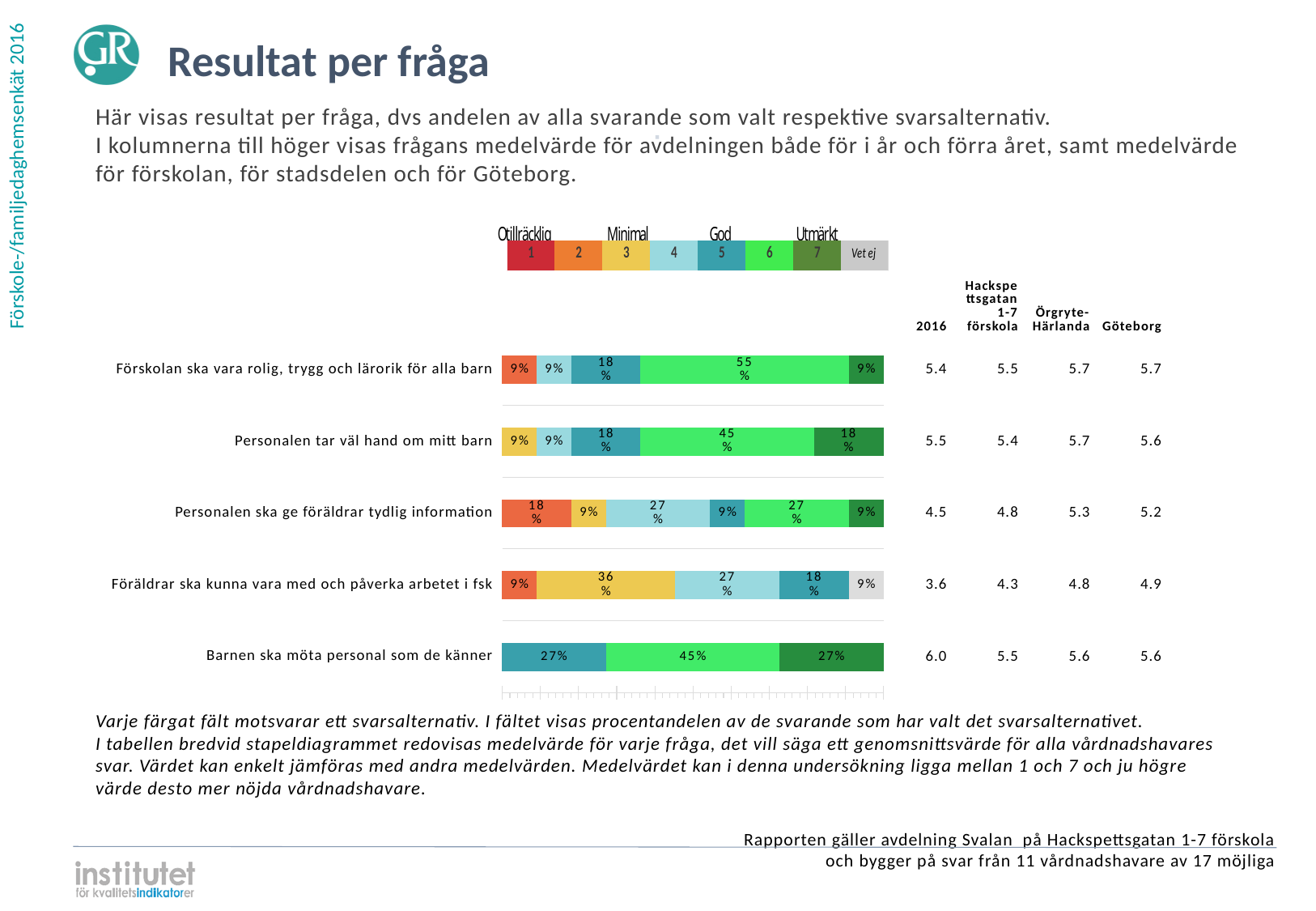
What is the combined share of options 6 and 7 for 'Barnen ska möta personal som de känner'? 72% What percentage of respondents chose option 3 (yellow) for 'Föräldrar ska kunna vara med och påverka arbetet i fsk'? 36% Which question has the largest single segment in its bar? Förskolan ska vara rolig, trygg och lärorik för alla barn How many response options does the legend above the chart list, including 'Vet ej'? 8 What percentage of respondents chose option 6 (bright green) for 'Förskolan ska vara rolig, trygg och lärorik för alla barn'? 55% What kind of chart is shown on the slide? Stacked bar chart For 'Barnen ska möta personal som de känner', which is larger: the option 6 (bright green) share or the option 5 (teal) share? Option 6 (45%) What percentage of respondents answered 'Vet ej' (grey) for 'Föräldrar ska kunna vara med och påverka arbetet i fsk'? 9% How many questions (categories) are plotted as bars in the chart? 5 What percentage of respondents chose option 7 (dark green) for 'Personalen tar väl hand om mitt barn'? 18% For 'Personalen ska ge föräldrar tydlig information', what is the difference between the option 4 (light blue) share and the option 2 (orange) share? 9% What is the 2016 mean value shown for 'Barnen ska möta personal som de känner'? 6.0